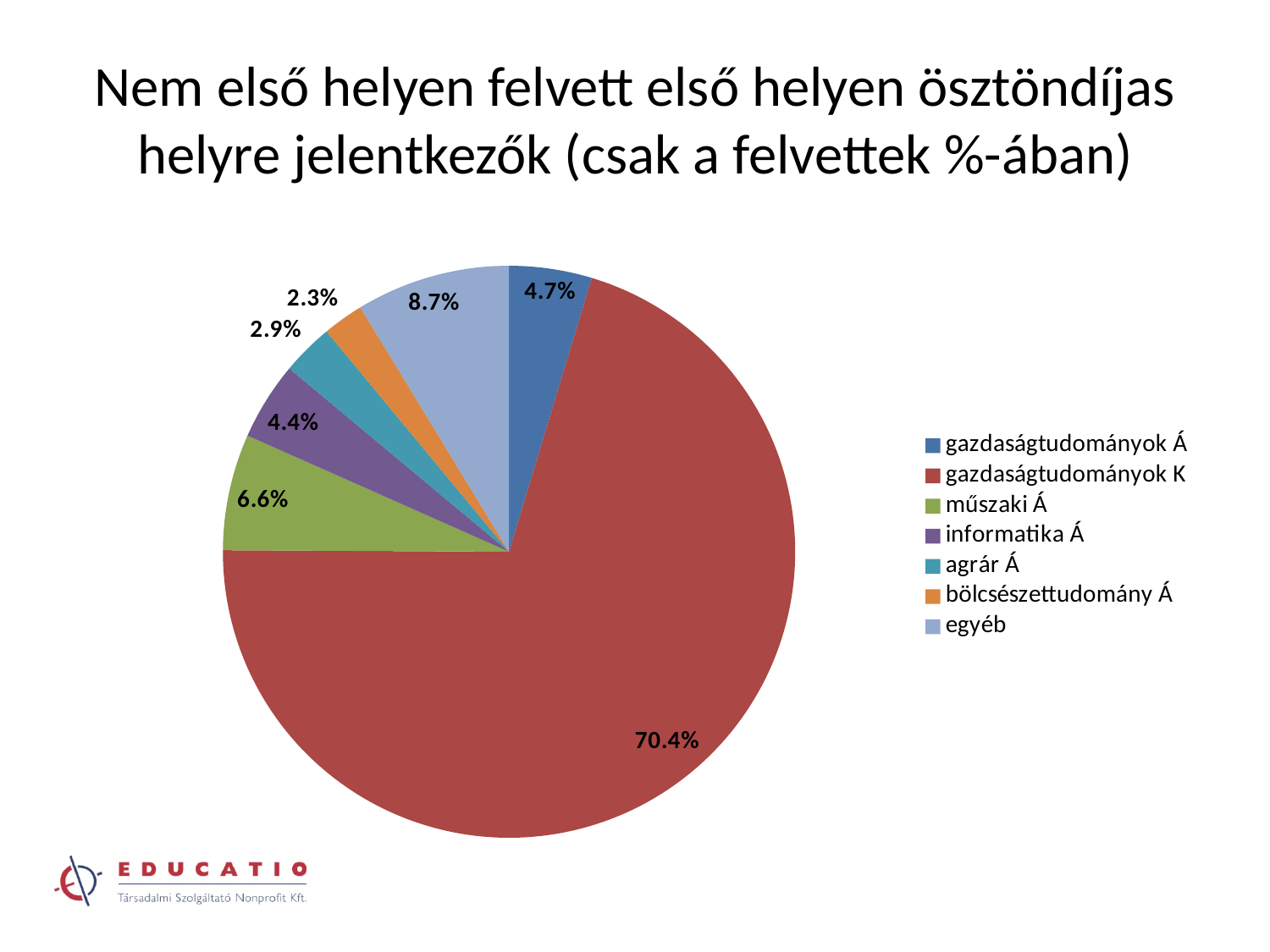
Which is larger, the share for gazdaságtudományok Á or the share for informatika Á? gazdaságtudományok Á What is the share for agrár Á? 2.9% Which category has the smallest slice of the pie? bölcsészettudomány Á Which category has the largest slice of the pie? gazdaságtudományok K What is the share for gazdaságtudományok K? 70.4% What is the share for műszaki Á? 6.6% What is the share for bölcsészettudomány Á? 2.3% What is the difference between the shares of egyéb and műszaki Á? 2.1% How many categories does the legend list? 7 What is the share for egyéb? 8.7% What type of chart is shown on the slide? pie chart What colour is the slice for gazdaságtudományok K? red